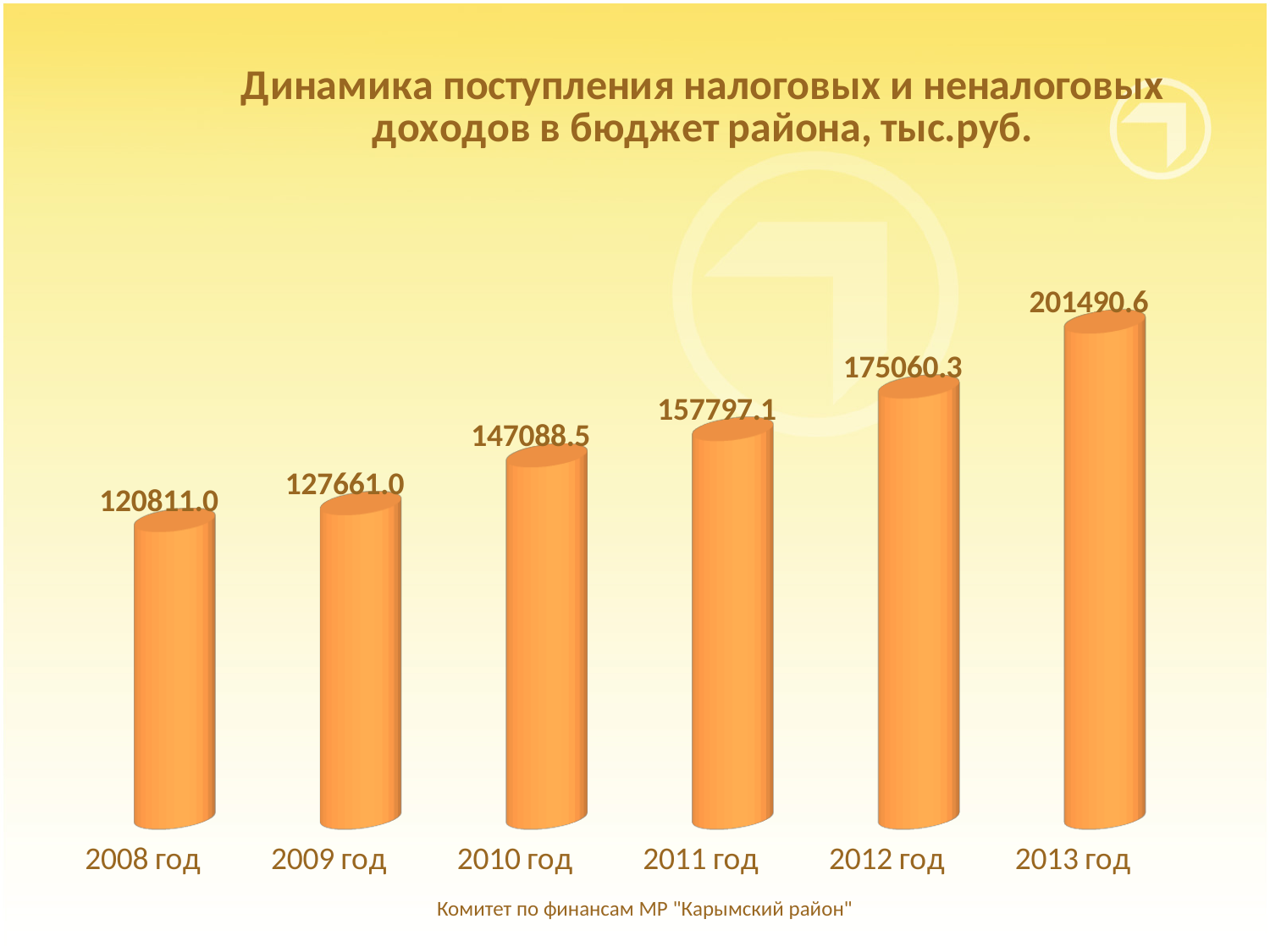
What is the value for 2008 год? 120811.0 What is the value for 2011 год? 157797.1 Which is larger, the value for 2010 год or the value for 2009 год? 2010 год Which year has the lowest value? 2008 год How many years are shown on the chart? 6 What is the difference between the values for 2013 год and 2008 год? 80679.6 Which year has the highest value? 2013 год What is the value for 2013 год? 201490.6 Do the values rise or fall from 2008 год to 2013 год? Rise What kind of chart is shown on the slide? Bar chart In what units are the values on the chart expressed, according to the title? тыс.руб. What is the difference between the values for 2012 год and 2011 год? 17263.2